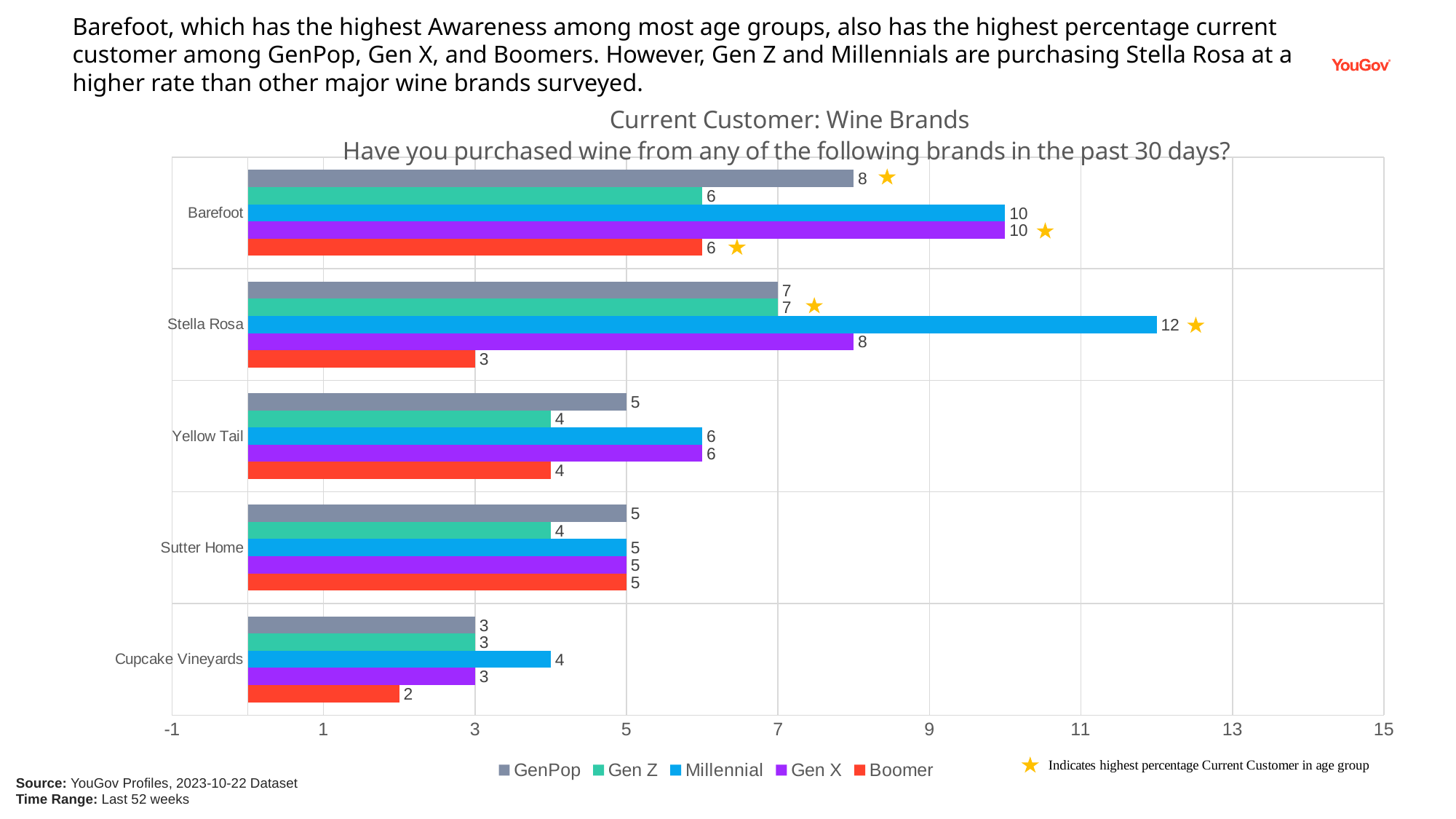
What is the Gen X value for Yellow Tail? 6 What kind of chart is shown on the slide? Bar chart What is the Millennial value for Stella Rosa? 12 Which is larger for Barefoot: the Gen X value or the Gen Z value? Gen X What does the star symbol on the chart indicate? Highest percentage Current Customer in age group What is the difference between the Millennial and Boomer values for Stella Rosa? 9 Which brand has the highest Millennial value? Stella Rosa How many series does the legend list? 5 What is the Boomer value for Cupcake Vineyards? 2 Which brand has the lowest Boomer value? Cupcake Vineyards How many wine brands are shown on the chart? 5 What is the GenPop value for Barefoot? 8